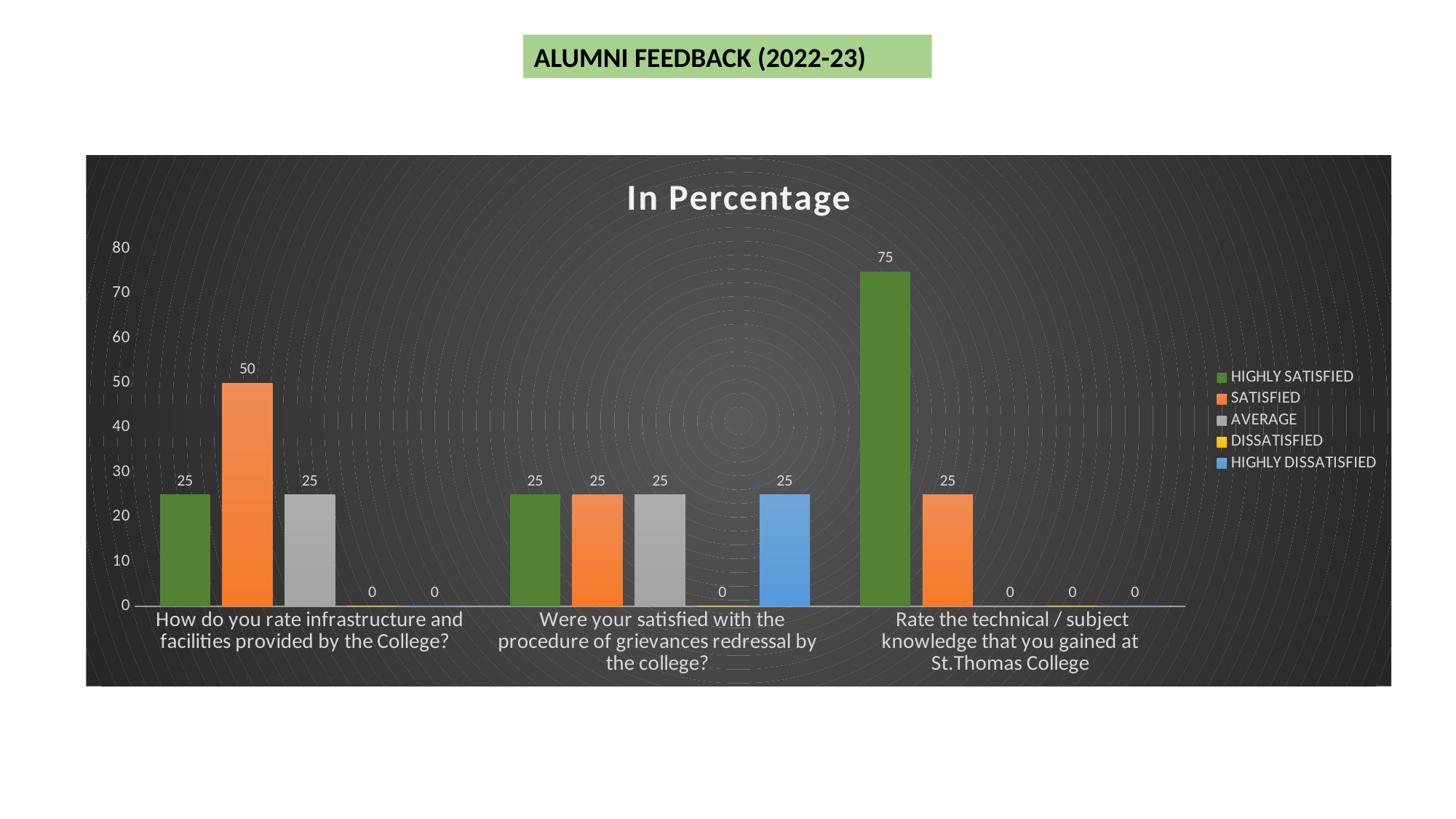
What is the AVERAGE value for "Rate the technical / subject knowledge that you gained at St.Thomas College"? 0 How many categories (questions) are shown on the x axis? 3 What is the SATISFIED value for "How do you rate infrastructure and facilities provided by the College?" 50 Which category has the highest HIGHLY SATISFIED value? Rate the technical / subject knowledge that you gained at St.Thomas College What is the HIGHLY DISSATISFIED value for "Were your satisfied with the procedure of grievances redressal by the college?" 25 Which series is shown in green? HIGHLY SATISFIED How many series does the legend list? 5 What is the title of the chart? In Percentage For the infrastructure and facilities question, which is larger: the SATISFIED value or the AVERAGE value? SATISFIED What type of chart is shown on the slide? bar chart What is the difference between the HIGHLY SATISFIED value for the technical / subject knowledge question and the HIGHLY SATISFIED value for the infrastructure question? 50 What is the HIGHLY SATISFIED value for "Rate the technical / subject knowledge that you gained at St.Thomas College"? 75